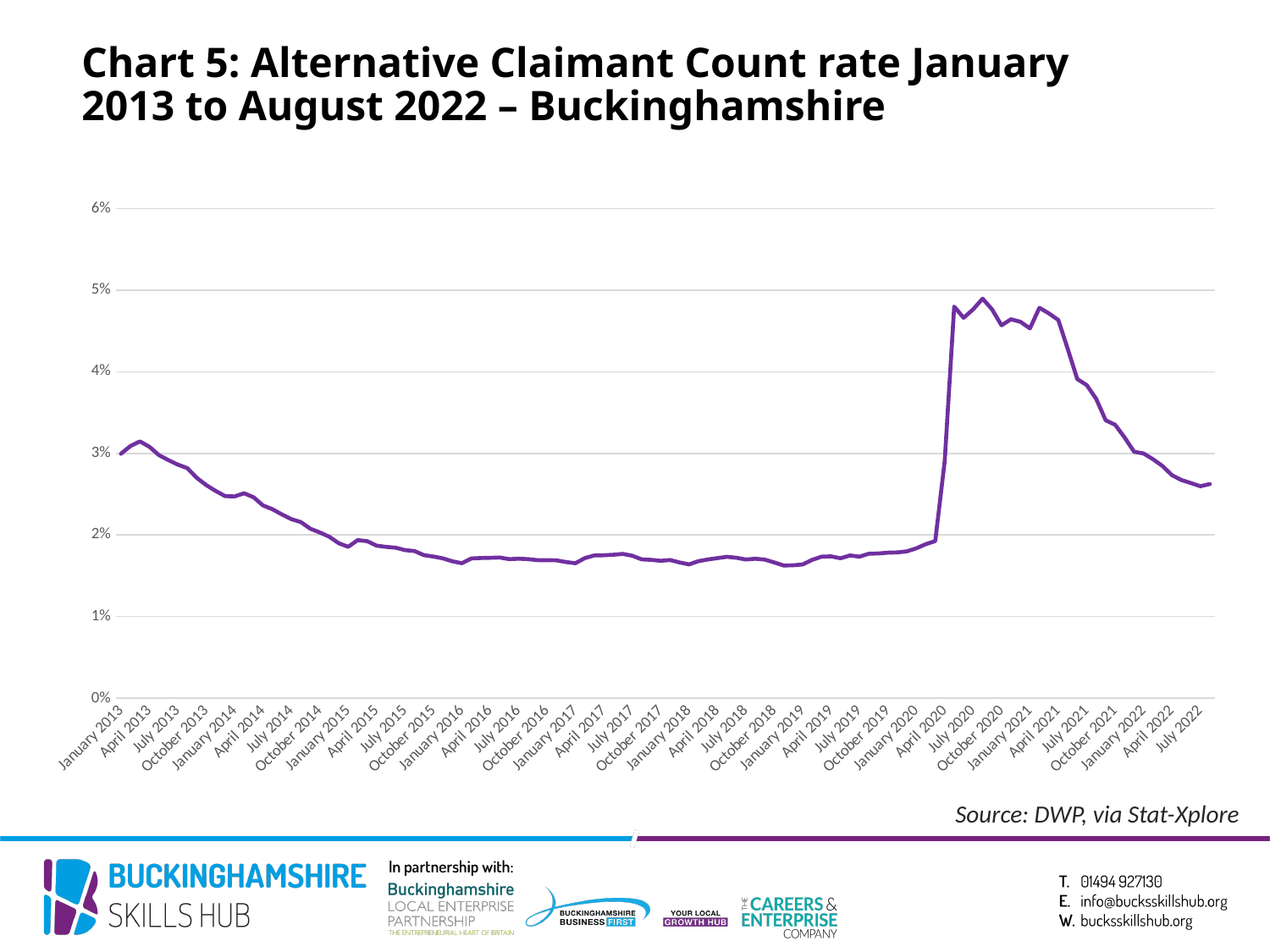
What source is cited for the chart? DWP, via Stat-Xplore In which year does the line reach its highest point? 2020 Is the value for July 2022 greater or less than 3%? less What kind of chart is shown on the slide? line chart Is the value for April 2020 greater or less than 2%? greater What is the title of the chart? Chart 5: Alternative Claimant Count rate January 2013 to August 2022 – Buckinghamshire Does the claimant count rate rise or fall between January 2013 and January 2016? fall Does the claimant count rate rise or fall between July 2021 and July 2022? fall Is the value for July 2020 greater or less than 4%? greater Which is larger, the value for July 2020 or the value for January 2013? July 2020